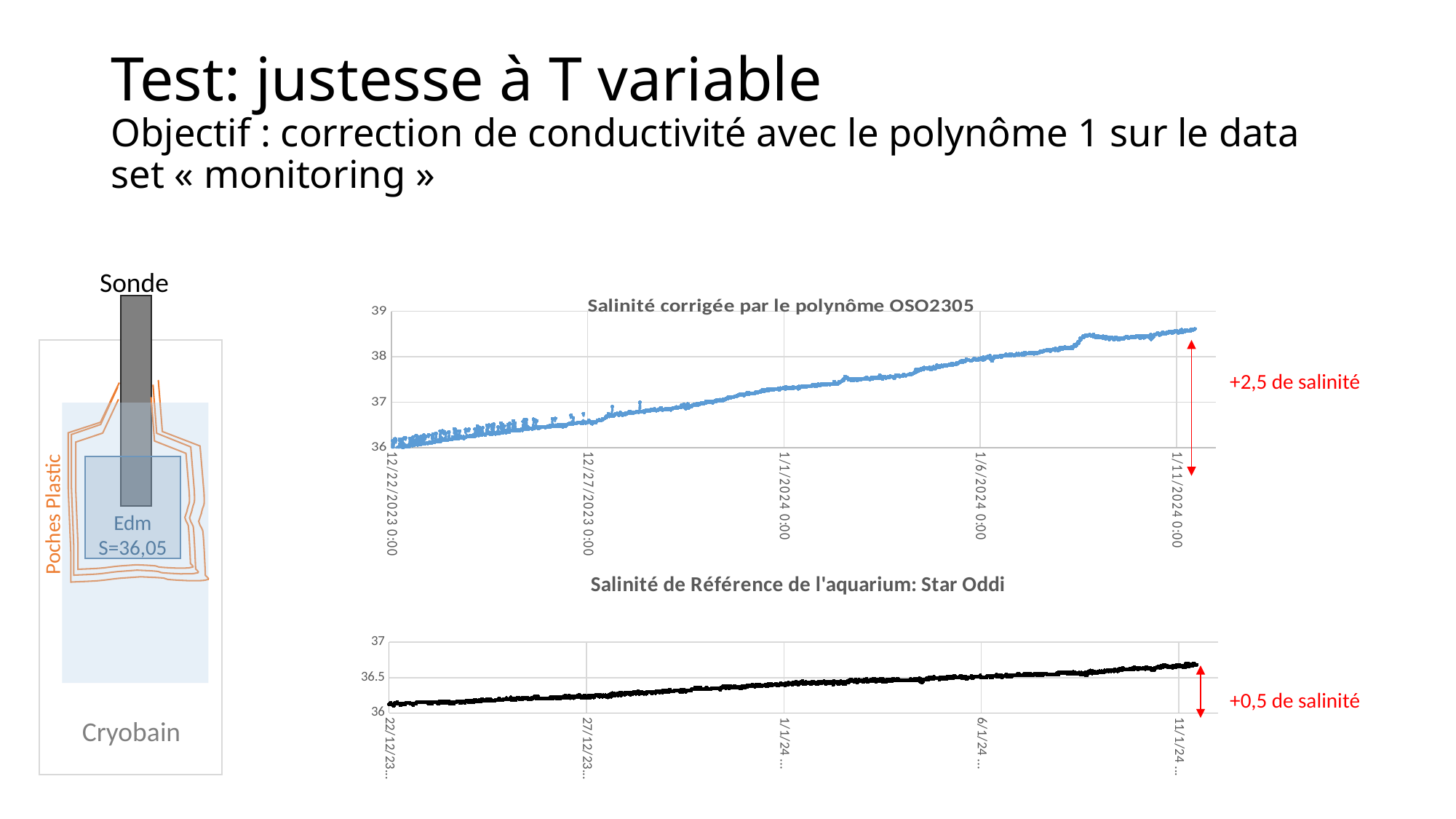
What colour is the line in the bottom chart "Salinité de Référence de l'aquarium: Star Oddi"? black What kind of chart is the top chart titled "Salinité corrigée par le polynôme OSO2305"? line chart How many date labels are shown on the x axis of the top chart "Salinité corrigée par le polynôme OSO2305"? 5 According to the red annotation next to the top chart, by how much does the corrected salinity increase over the period? +2,5 de salinité According to the red annotation next to the bottom chart, by how much does the reference salinity increase over the period? +0,5 de salinité In the top chart "Salinité corrigée par le polynôme OSO2305", do the values rise or fall from 12/22/2023 to 1/11/2024? rise In the bottom chart "Salinité de Référence de l'aquarium: Star Oddi", is the value at 22/12/23 greater or less than 36.5? less In the top chart "Salinité corrigée par le polynôme OSO2305", is the value at 1/11/2024 0:00 greater or less than 38? greater In the bottom chart "Salinité de Référence de l'aquarium: Star Oddi", do the values rise or fall along the x axis? rise What kind of chart is the bottom chart titled "Salinité de Référence de l'aquarium: Star Oddi"? line chart In the bottom chart "Salinité de Référence de l'aquarium: Star Oddi", is the value at 11/1/24 greater or less than 36.5? greater